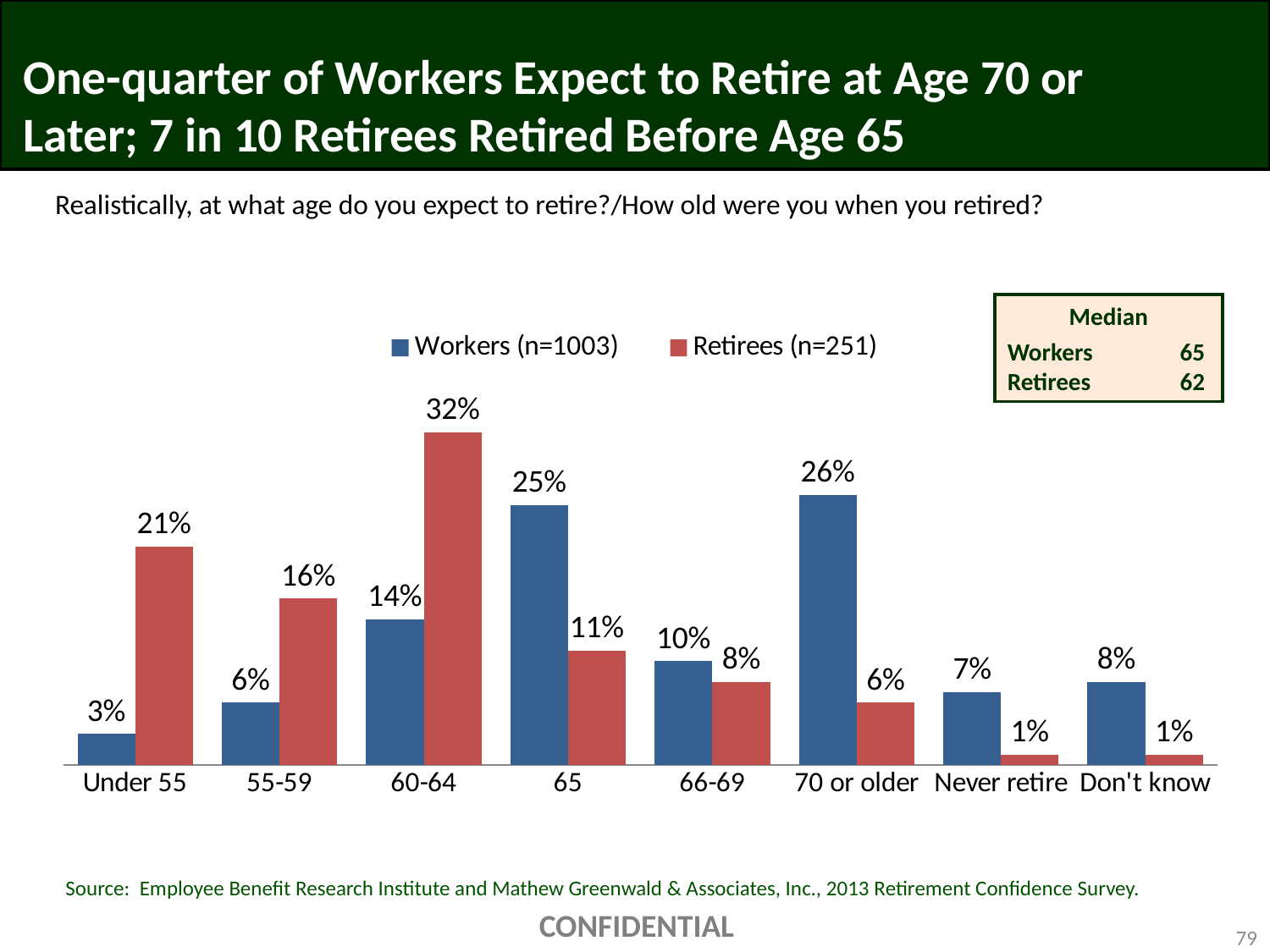
Which category has the highest value for Retirees (n=251)? 60-64 What kind of chart is shown on the slide? Bar chart What percentage of Retirees (n=251) retired at age 60-64? 32% How many series does the legend list? 2 Which category has the lowest value for Workers (n=1003)? Under 55 What is the median retirement age for Retirees shown in the box? 62 What colour are the bars for Retirees (n=251)? Red Which is larger for the 66-69 category: Workers (n=1003) or Retirees (n=251)? Workers (n=1003) What is the value for Workers (n=1003) in the 65 category? 25% What percentage of Workers (n=1003) expect to retire at 70 or older? 26% How many age categories are shown on the x axis? 8 What is the difference between the Retirees (n=251) and Workers (n=1003) values for Under 55? 18%